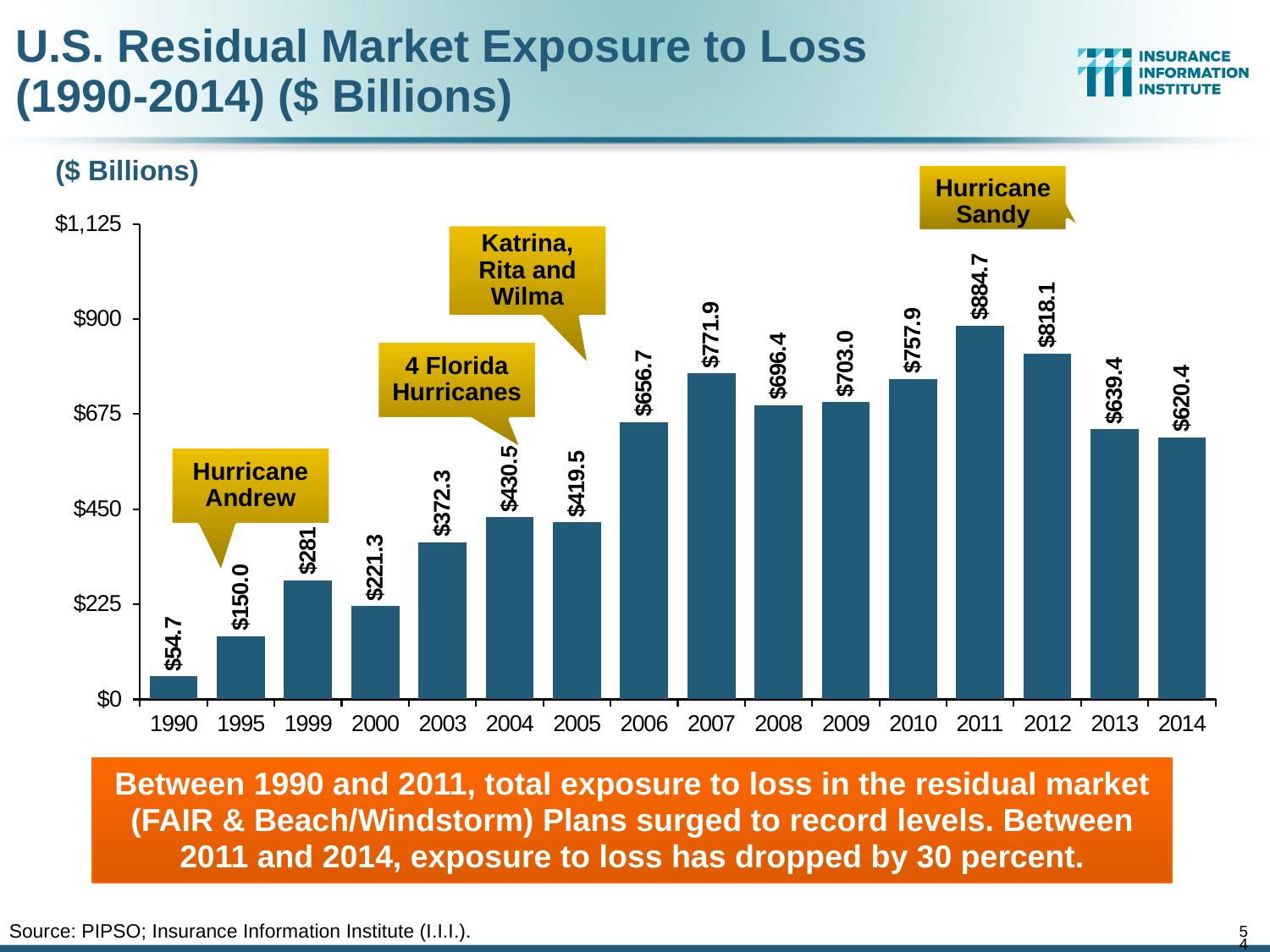
What is the value shown for 2005? $419.5 Do the values rise or fall from 2011 to 2014? Fall How many years are shown on the x axis? 16 What is the difference between the values for 2012 and 2013? $178.7 Which year has a larger value, 2008 or 2009? 2009 Which year has the highest exposure to loss? 2011 Which hurricane is labelled in the callout above the 1995 bar? Hurricane Andrew What is the U.S. residual market exposure to loss for 2011? $884.7 What is the value shown for 1990? $54.7 Which year has the lowest exposure to loss? 1990 What kind of chart is shown on the slide? Bar chart